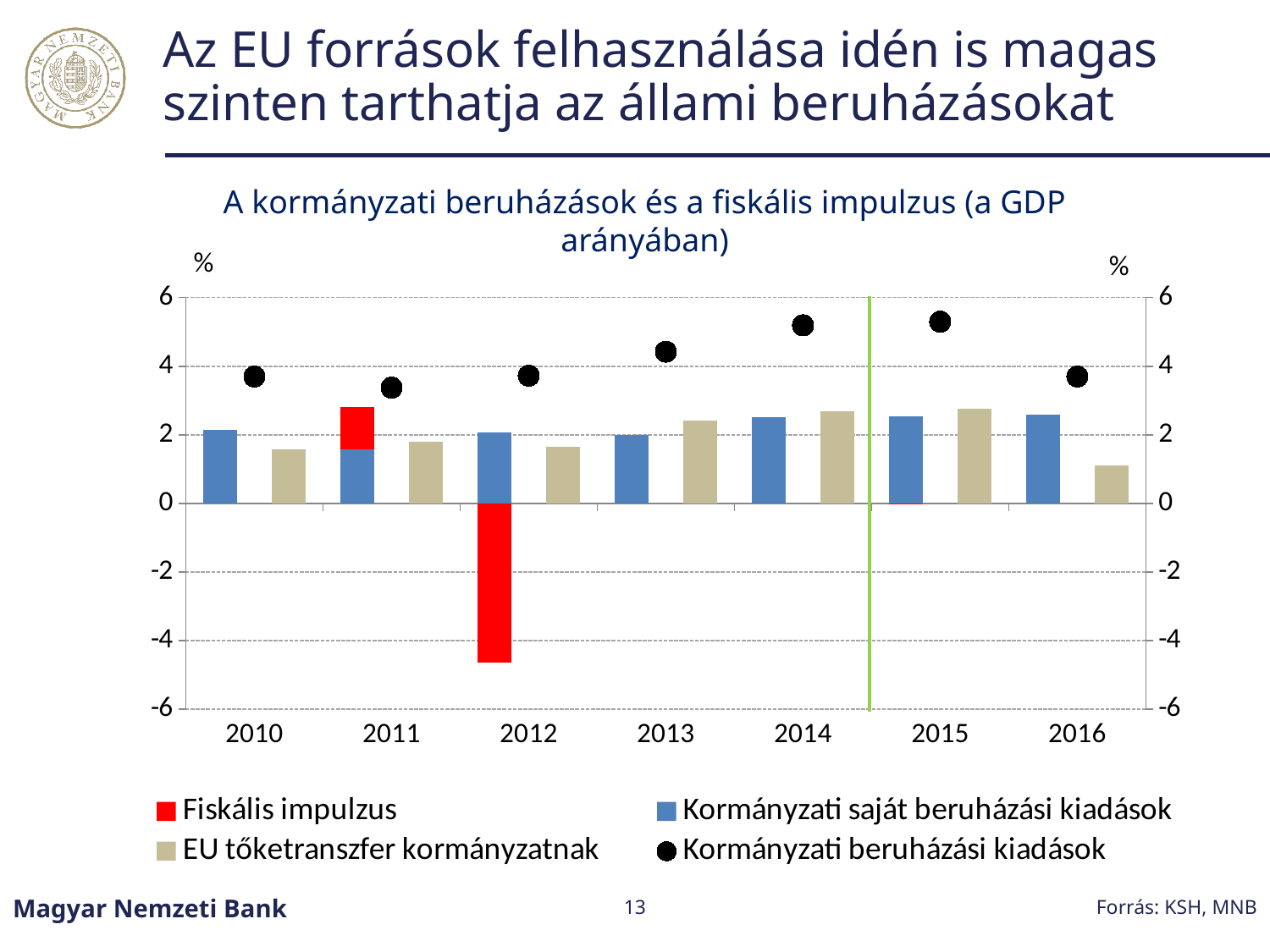
In 2016, which is larger: Kormányzati saját beruházási kiadások or EU tőketranszfer kormányzatnak? Kormányzati saját beruházási kiadások In 2013, which is larger: Kormányzati saját beruházási kiadások or EU tőketranszfer kormányzatnak? EU tőketranszfer kormányzatnak Does Kormányzati beruházási kiadások rise or fall from 2011 to 2015? rise Is the value of Kormányzati beruházási kiadások in 2014 greater or less than 4? greater In which year is EU tőketranszfer kormányzatnak the lowest? 2016 How many years are shown on the x axis? 7 How many series does the legend list? 4 Is the value of EU tőketranszfer kormányzatnak in 2016 greater or less than 2? less In which year is Kormányzati saját beruházási kiadások the lowest? 2011 What kind of chart is shown on the slide? combination bar and line chart (bars with dot markers) Is the value of Fiskális impulzus in 2012 greater or less than -4? less